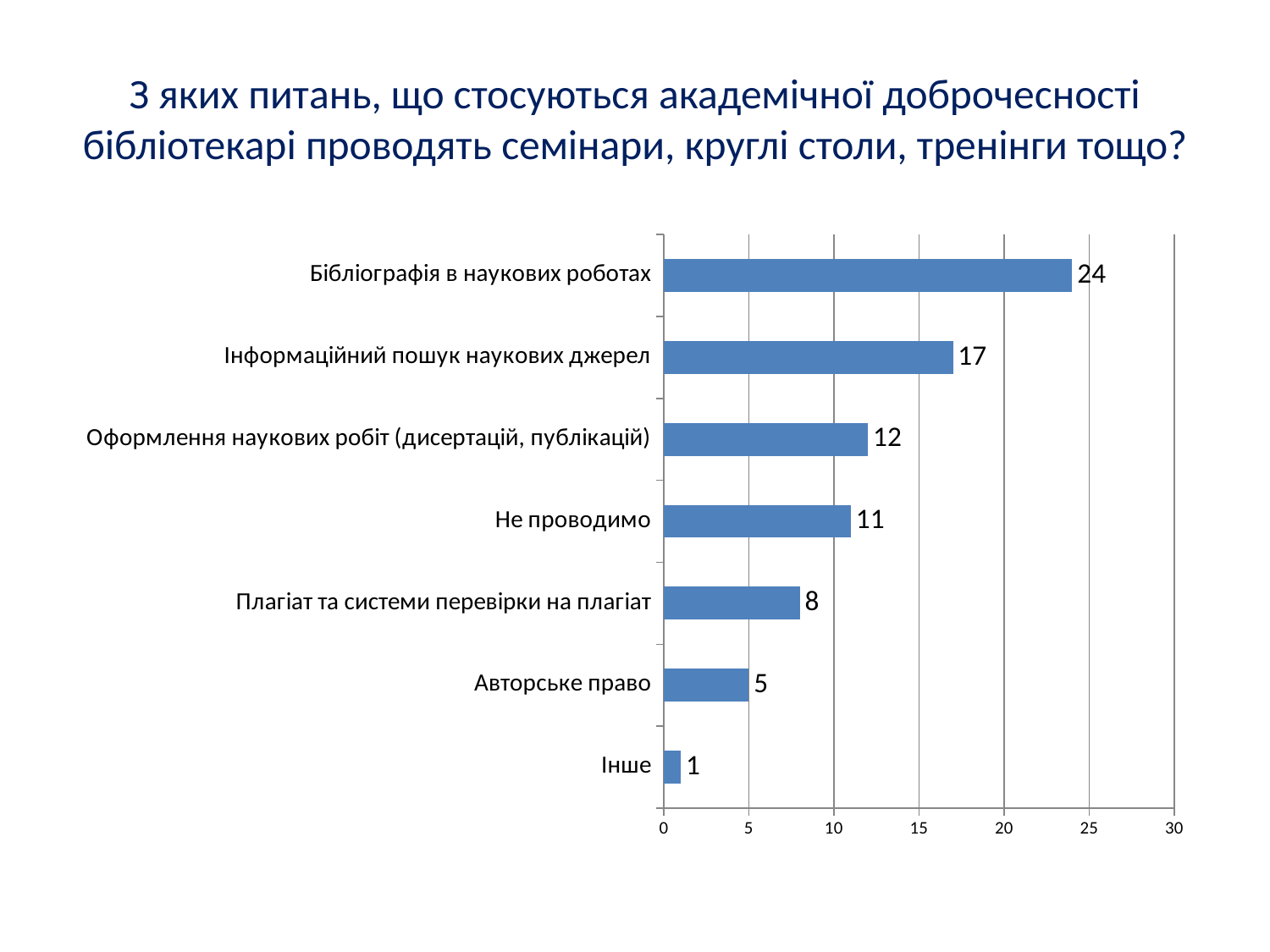
How many categories are shown in the chart? 7 What is the maximum value shown on the horizontal axis? 30 What is the difference between the values for Бібліографія в наукових роботах and Інформаційний пошук наукових джерел? 7 Which is larger: the value for Оформлення наукових робіт (дисертацій, публікацій) or the value for Плагіат та системи перевірки на плагіат? Оформлення наукових робіт (дисертацій, публікацій) What is the value for Не проводимо? 11 Which category has the highest value? Бібліографія в наукових роботах What is the value for Авторське право? 5 What kind of chart is shown on the slide? bar chart Which category has the lowest value? Інше Is the value for Інформаційний пошук наукових джерел greater or less than 15? greater What is the difference between the values for Плагіат та системи перевірки на плагіат and Авторське право? 3 What is the value for Бібліографія в наукових роботах? 24